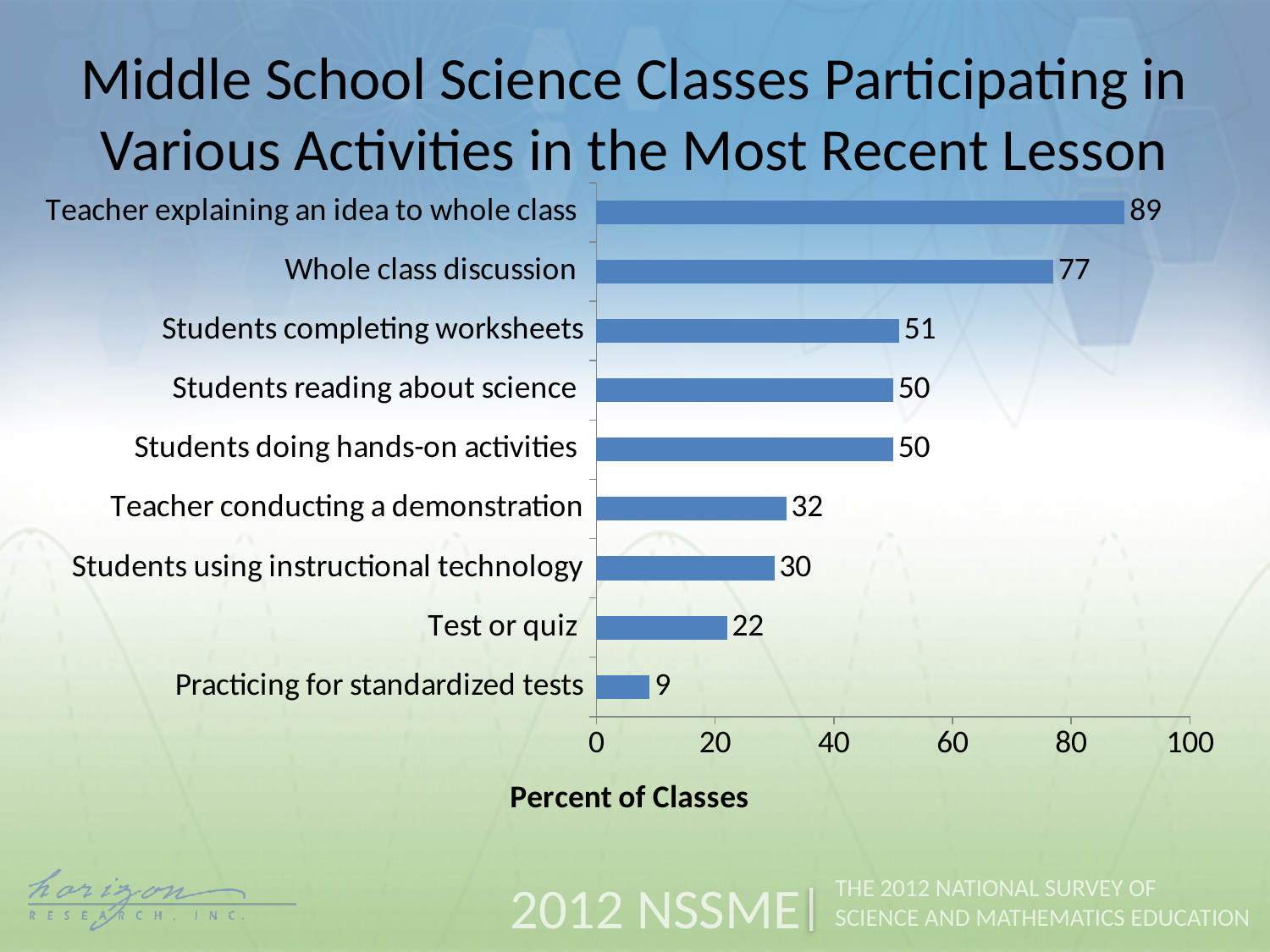
What is the value for Test or quiz? 22 Which activity has the lowest percent of classes? Practicing for standardized tests What kind of chart is shown on the slide? Bar chart Which activity has the highest percent of classes? Teacher explaining an idea to whole class Is the value for Teacher conducting a demonstration greater or less than 40? less What is the label of the horizontal axis? Percent of Classes What is the difference between Whole class discussion and Students completing worksheets? 26 How many activities are shown in the chart? 9 What percent of classes had the teacher explaining an idea to the whole class? 89 What is the value for Students using instructional technology? 30 What is the difference between Teacher conducting a demonstration and Practicing for standardized tests? 23 Which is larger, Whole class discussion or Students doing hands-on activities? Whole class discussion